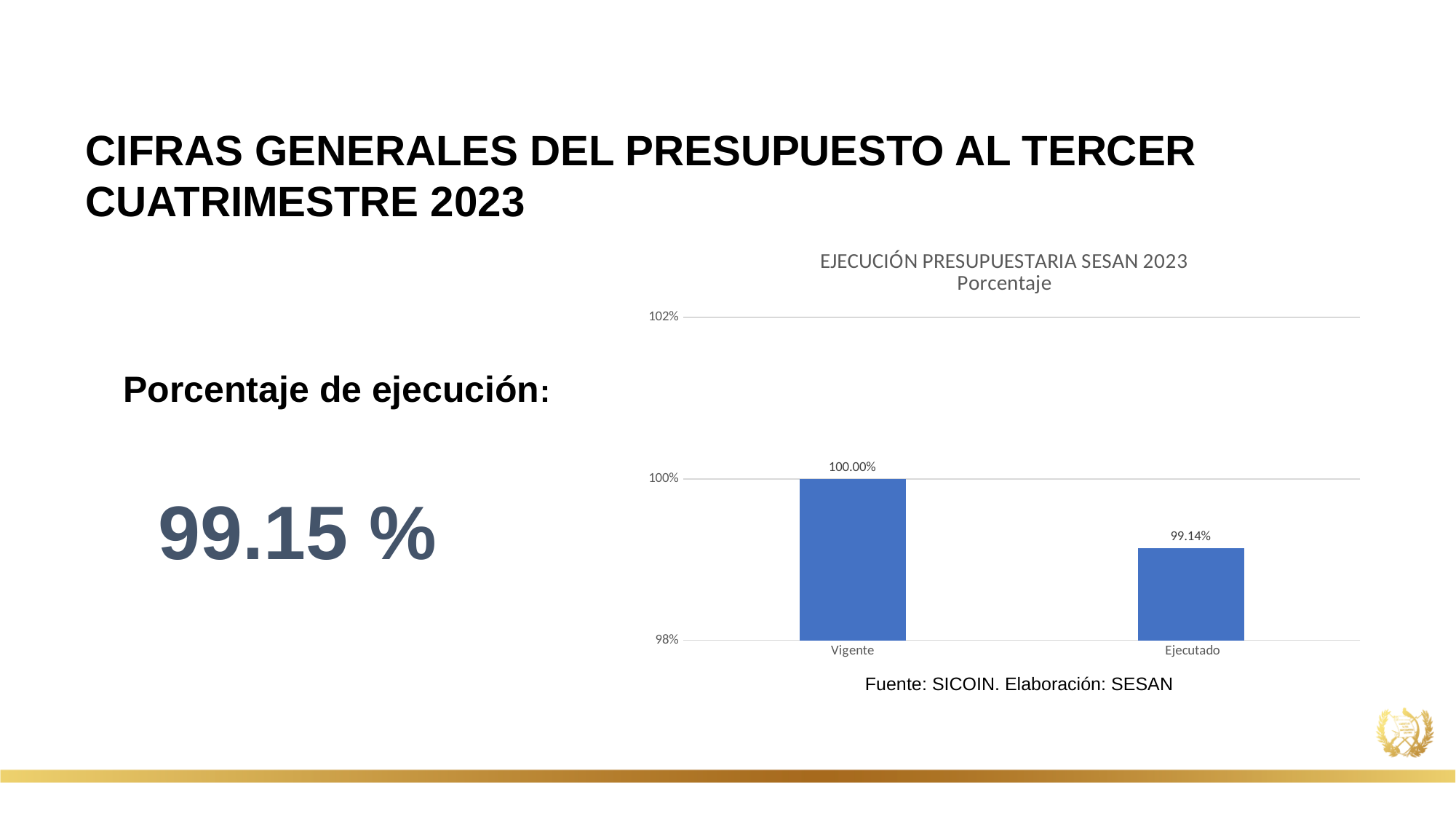
Is the value for Ejecutado greater or less than 100%? less Which is larger, the value for Vigente or the value for Ejecutado? Vigente Which category has the lowest value? Ejecutado What kind of chart is shown on the slide? bar chart What is the title of the chart? EJECUCIÓN PRESUPUESTARIA SESAN 2023 Porcentaje What is the value for Ejecutado? 99.14% What is the value for Vigente? 100.00% Which category has the highest value? Vigente What is the source cited below the chart? Fuente: SICOIN. Elaboración: SESAN What is the difference between the Vigente and Ejecutado values? 0.86% Do the values rise or fall from Vigente to Ejecutado? fall How many categories are shown in the chart? 2